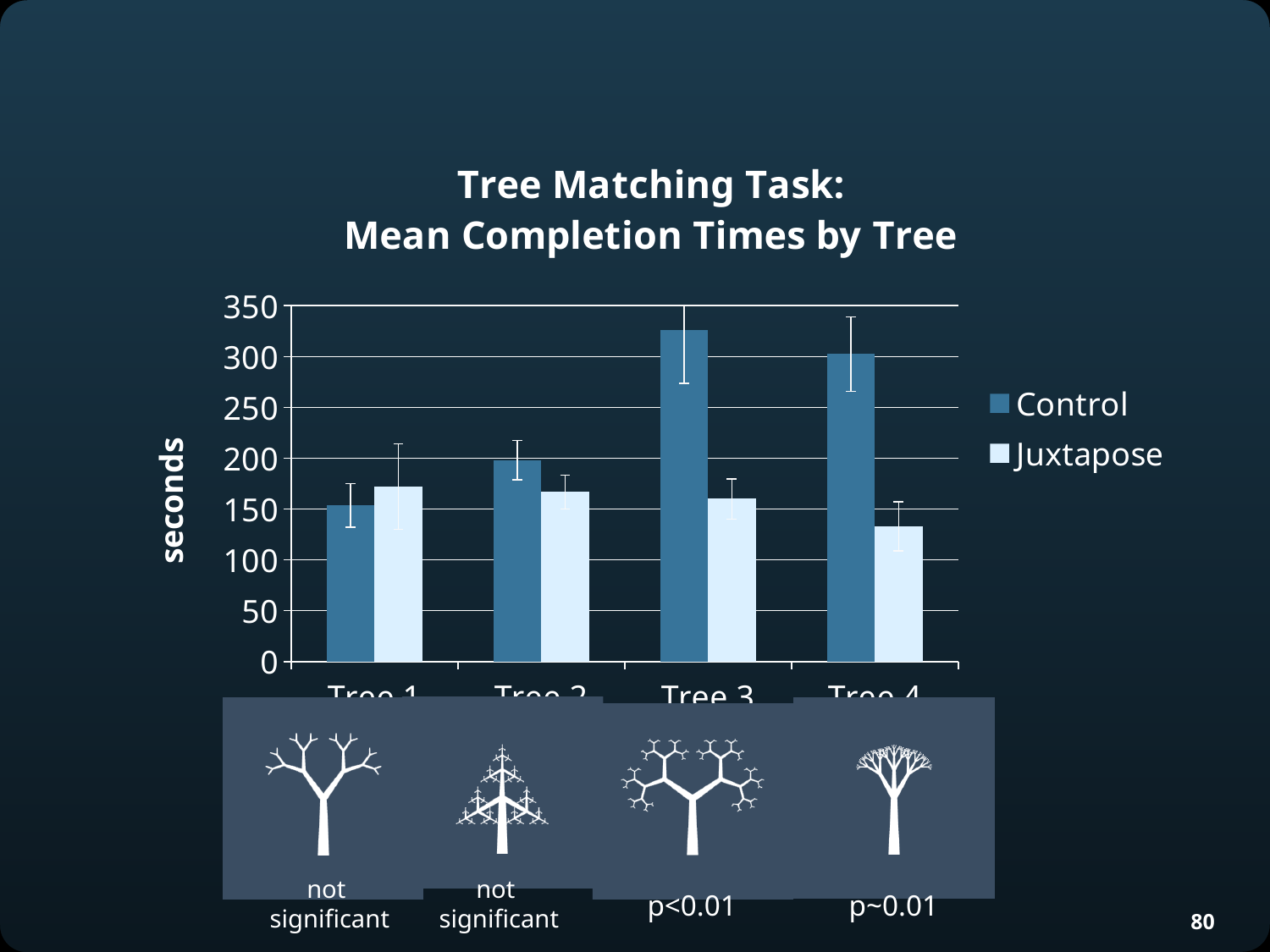
For which tree is the Control completion time highest? Tree 3 For Tree 3, which series has the larger completion time, Control or Juxtapose? Control Is the Juxtapose value for Tree 4 greater or less than 150? less Is the Control value for Tree 4 greater or less than 250? greater How many tree categories are shown on the x axis? 4 What is the label on the vertical axis? seconds Is the Control value for Tree 3 greater or less than 300? greater How many series does the legend list? 2 For which tree is the Juxtapose completion time lowest? Tree 4 What kind of chart is shown on the slide? bar chart For which tree is the Control completion time lowest? Tree 1 Which two series are listed in the legend? Control and Juxtapose